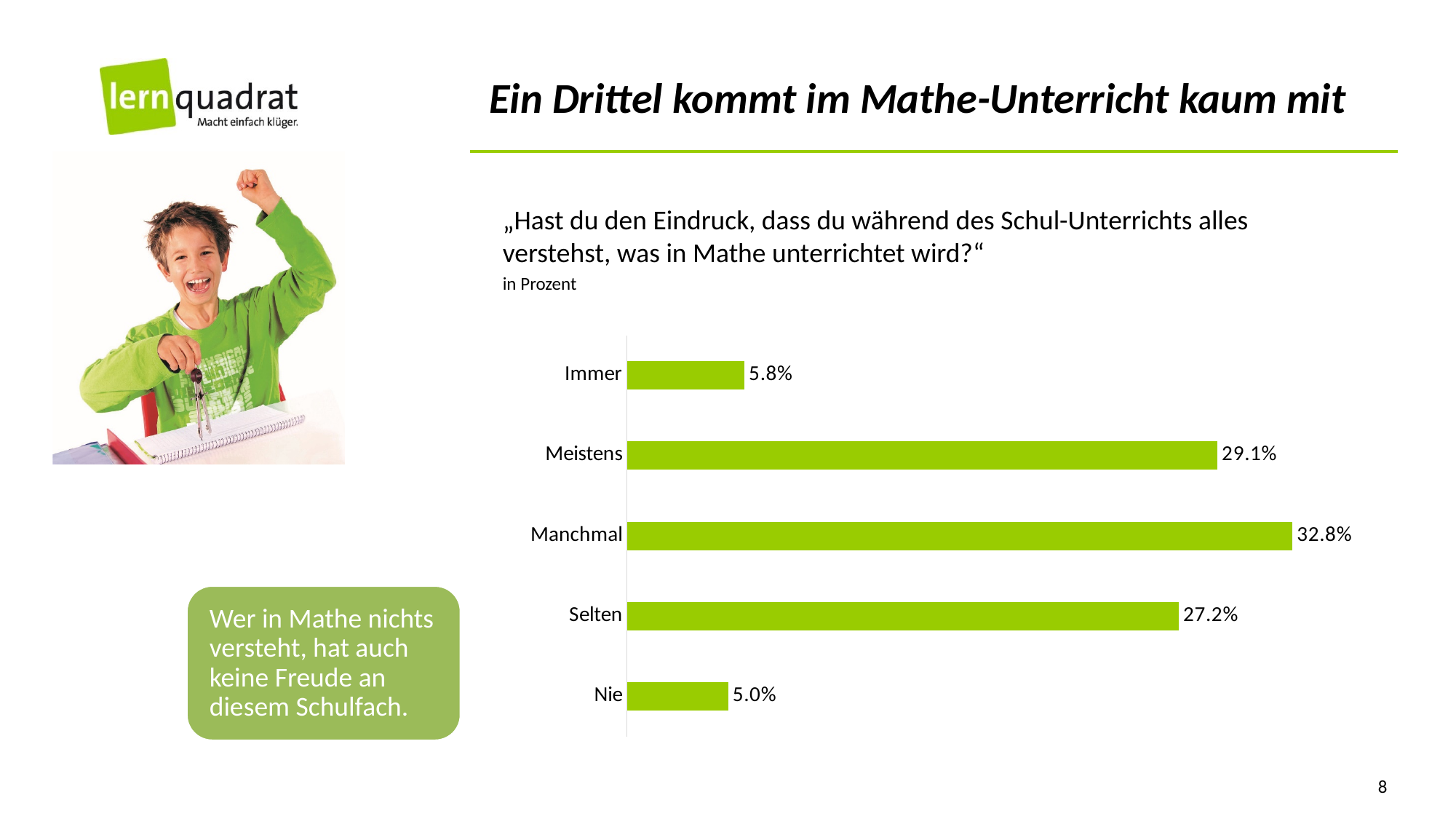
What is the value for Immer? 5.8% Which category has the lowest value? Nie What unit are the chart values given in, according to the note under the question? in Prozent What is the difference between the values for Manchmal and Meistens? 3.7% What is the value for Selten? 27.2% Which category has the highest value? Manchmal Which is larger, the value for Meistens or the value for Selten? Meistens What is the difference between the values for Immer and Nie? 0.8% What is the value for Manchmal? 32.8% How many categories are shown in the chart? 5 What is the combined value of Immer and Meistens? 34.9% What kind of chart is shown on the slide? Bar chart